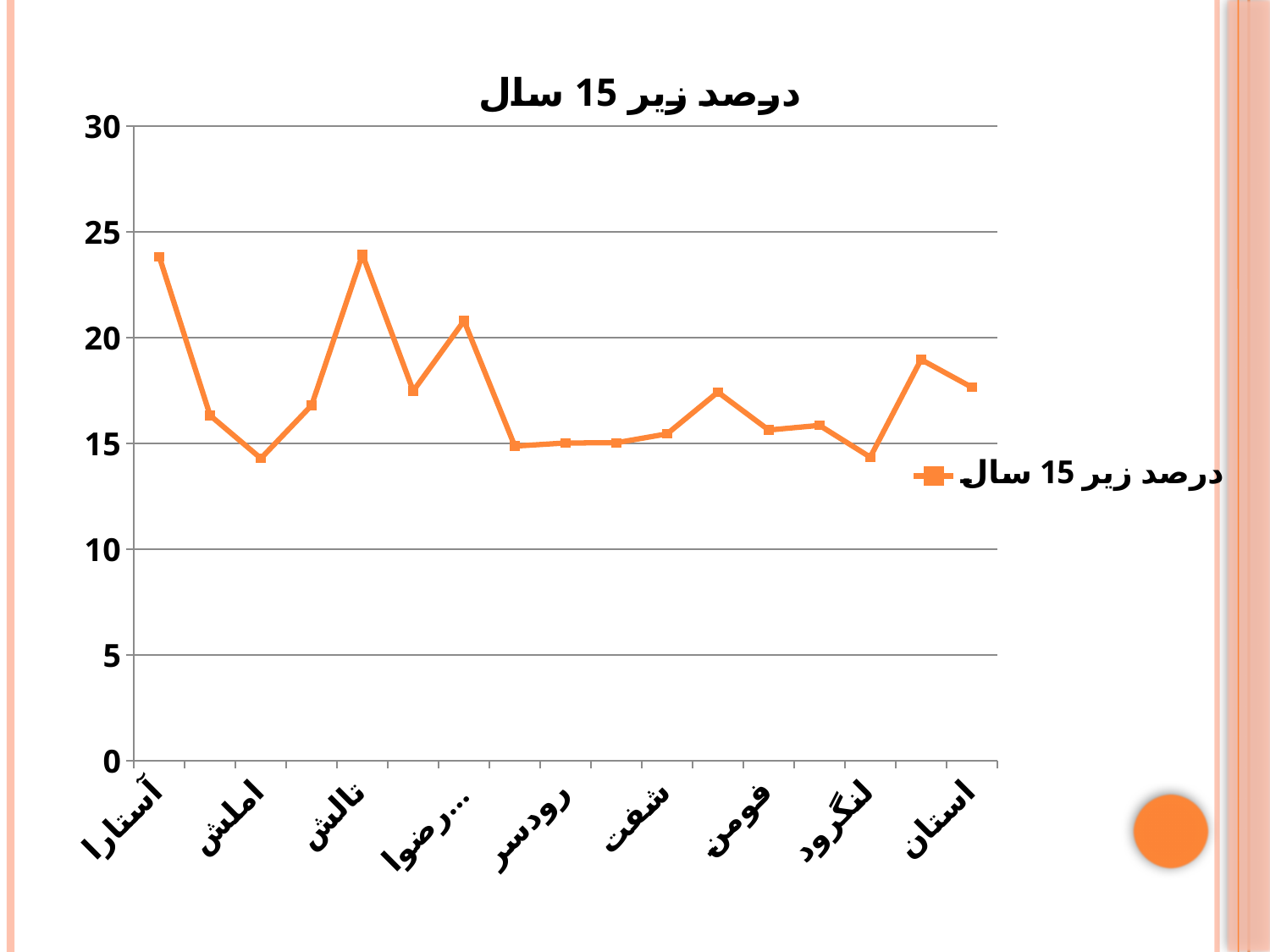
What kind of chart is shown on the slide? line chart How many series does the legend list? 1 Which has the larger value, آستارا or املش? آستارا What is the title of the chart? درصد زیر 15 سال Does the line rise or fall from آستارا to املش? fall Is the value for تالش greater or less than 20? greater Is the value for استان greater or less than 20? less Is the value for املش greater or less than 15? less How many data points are plotted on the line? 17 Which has the larger value, تالش or رودسر? تالش